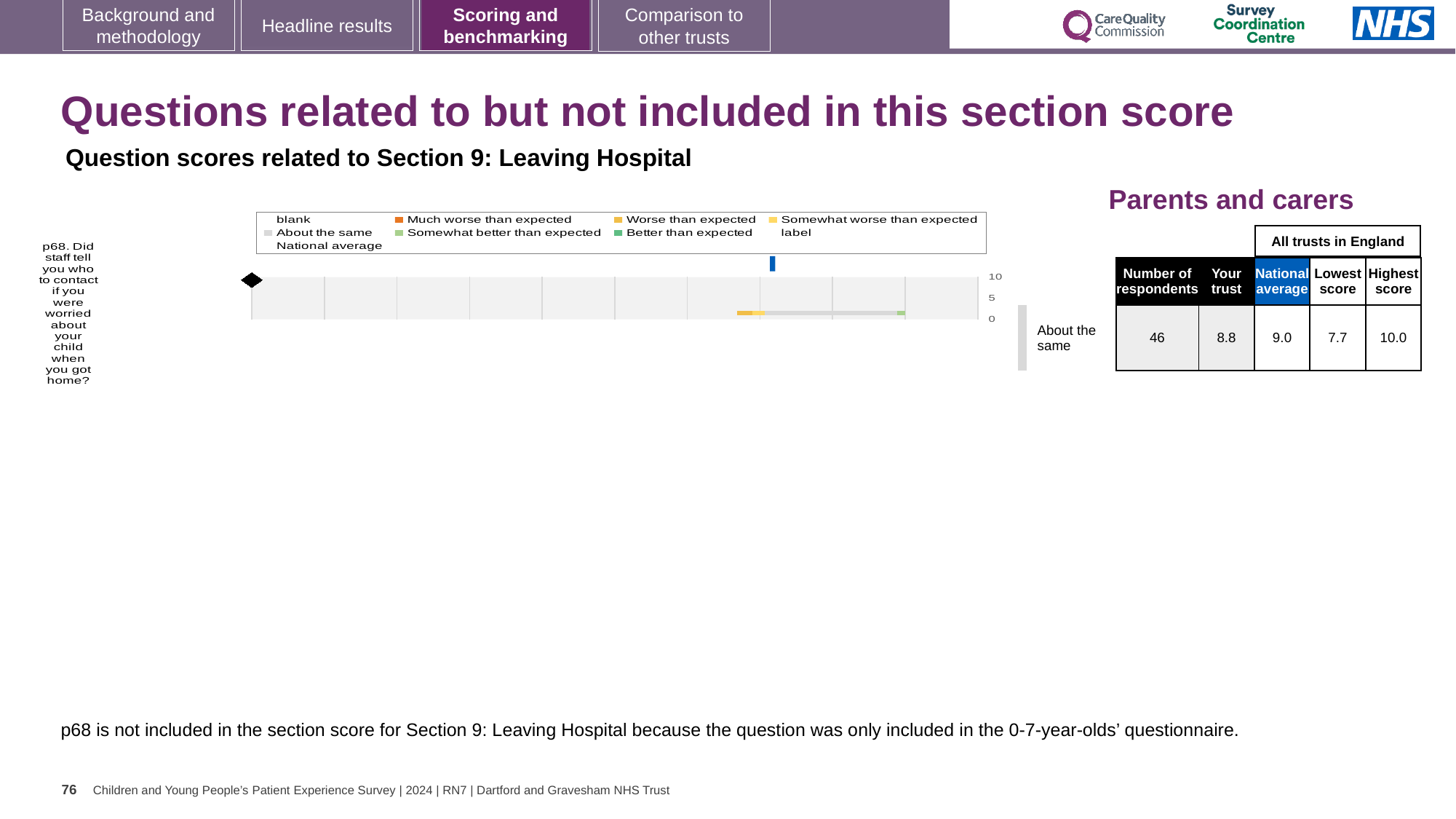
What is the highest score among all trusts in England for question p68? 10.0 Is the 'Your trust' score for question p68 greater or less than 5? greater What is the difference between the national average and the 'Your trust' score for question p68? 0.2 How many survey questions are plotted on the chart? 1 Which group of respondents does the chart on this slide cover? Parents and carers What is the lowest score among all trusts in England for question p68? 7.7 What is the national average score for question p68? 9.0 What is the difference between the highest and lowest scores among all trusts in England for question p68? 2.3 How is the trust's result for question p68 categorised relative to other trusts? About the same How many respondents answered question p68? 46 What is the 'Your trust' score for question p68 (Did staff tell you who to contact if you were worried about your child when you got home)? 8.8 Which is larger for question p68: the 'Your trust' score or the national average? National average